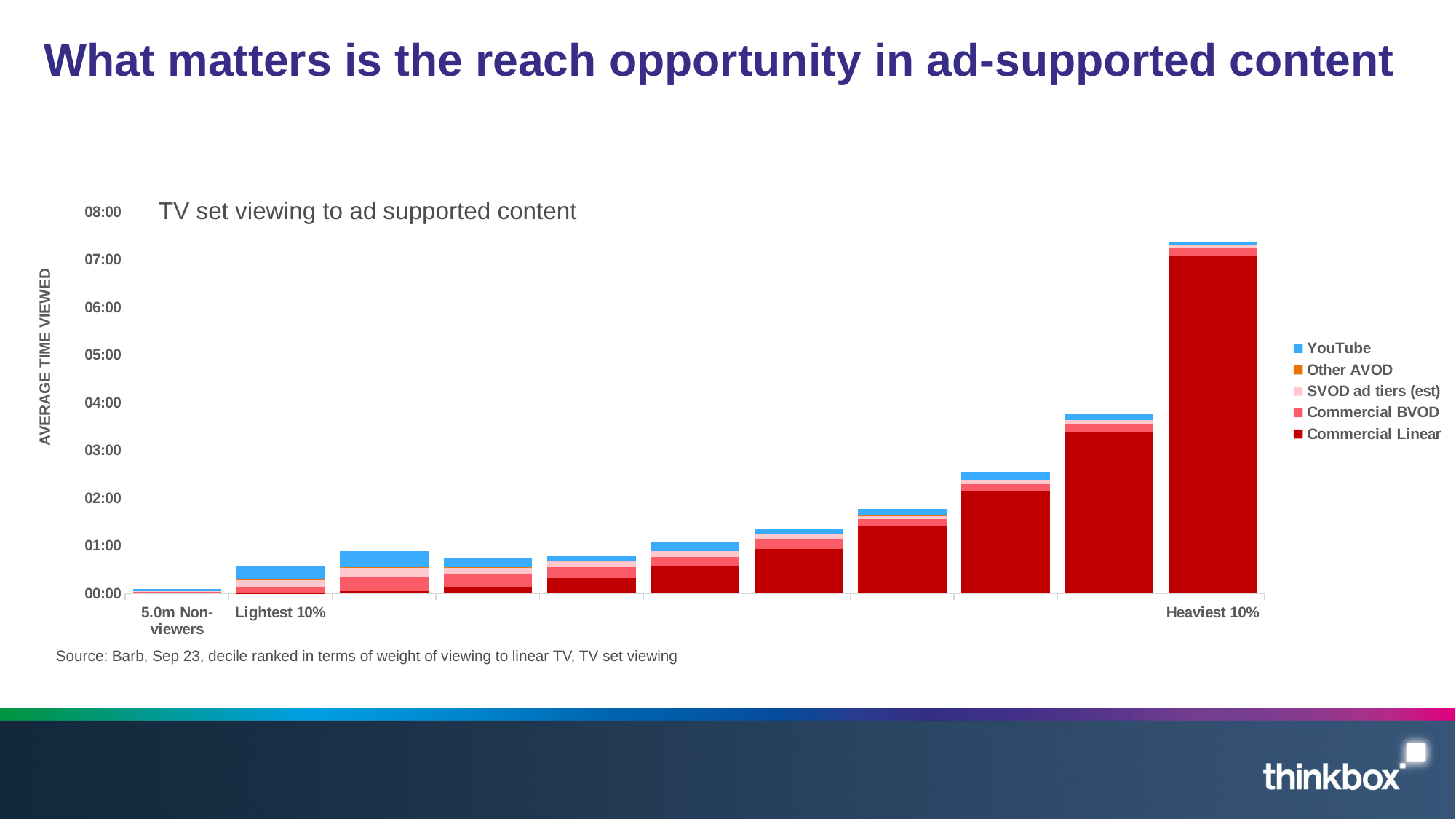
What is the title of the chart? TV set viewing to ad supported content Which category has the shortest stacked bar? 5.0m Non-viewers Is the total stacked value for Lightest 10% greater or less than 01:00? less What kind of chart is shown on the slide? Stacked bar chart Which series makes up the largest part of the Heaviest 10% bar? Commercial Linear How many bars are plotted in the chart? 11 Is the total stacked value for Heaviest 10% greater or less than 07:00? greater How many series does the legend list? 5 Do the stacked bar totals generally rise or fall from left to right across the x axis? rise What is the label on the vertical axis? AVERAGE TIME VIEWED Which is larger, the stacked bar for Heaviest 10% or the stacked bar for Lightest 10%? Heaviest 10% Which category has the tallest stacked bar? Heaviest 10%